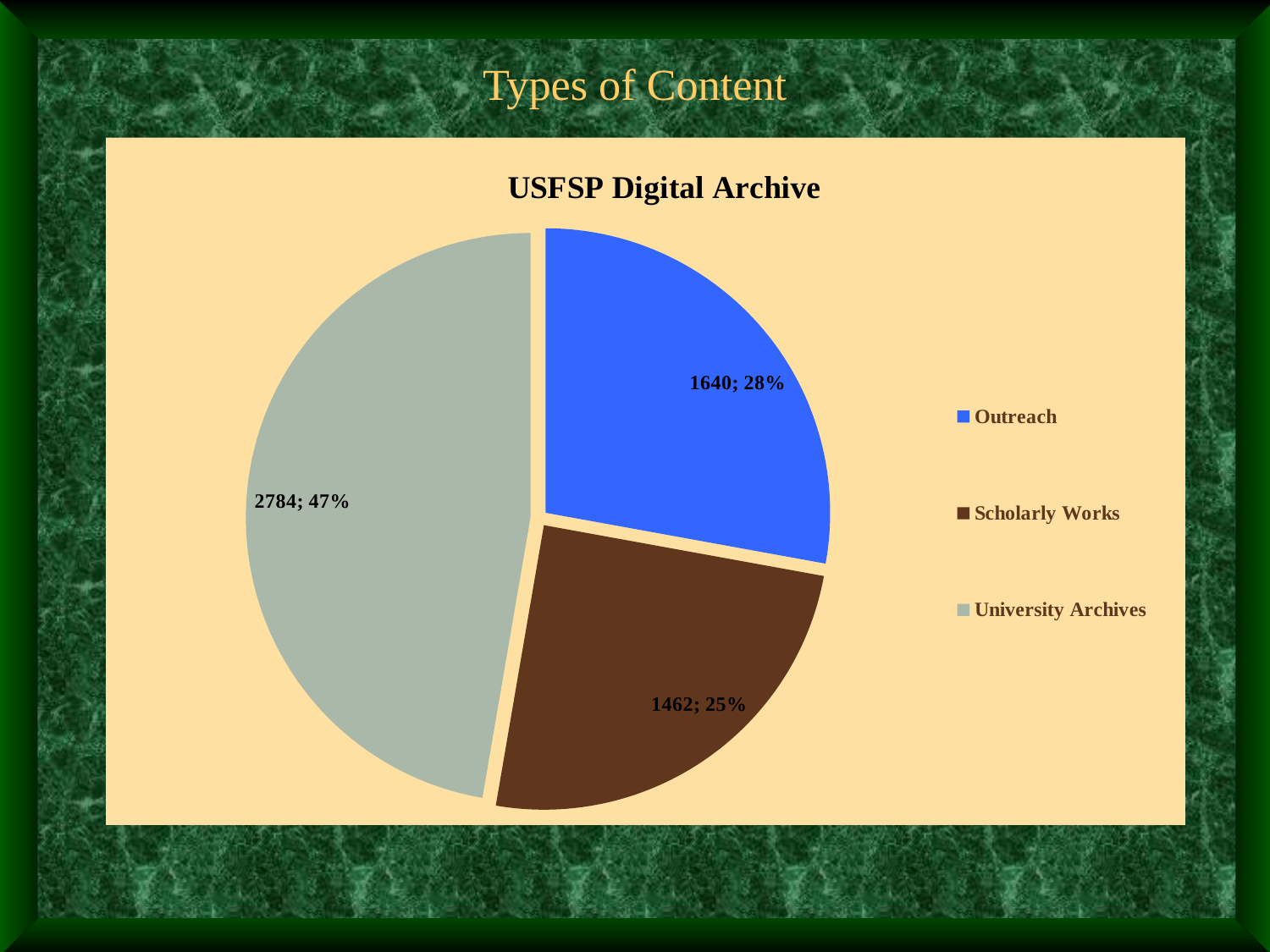
What is the value for University Archives? 2784 What is the value for Outreach? 1640 What type of chart is shown on the slide? pie chart Which is larger, the value for Outreach or the value for Scholarly Works? Outreach Which category has the largest slice? University Archives What is the difference between the values for University Archives and Outreach? 1144 What share of the pie does University Archives represent? 47% How many slices does the pie chart have? 3 What is the title of the chart? USFSP Digital Archive What share of the pie does Scholarly Works represent? 25% What is the value for Scholarly Works? 1462 Which category has the smallest slice? Scholarly Works